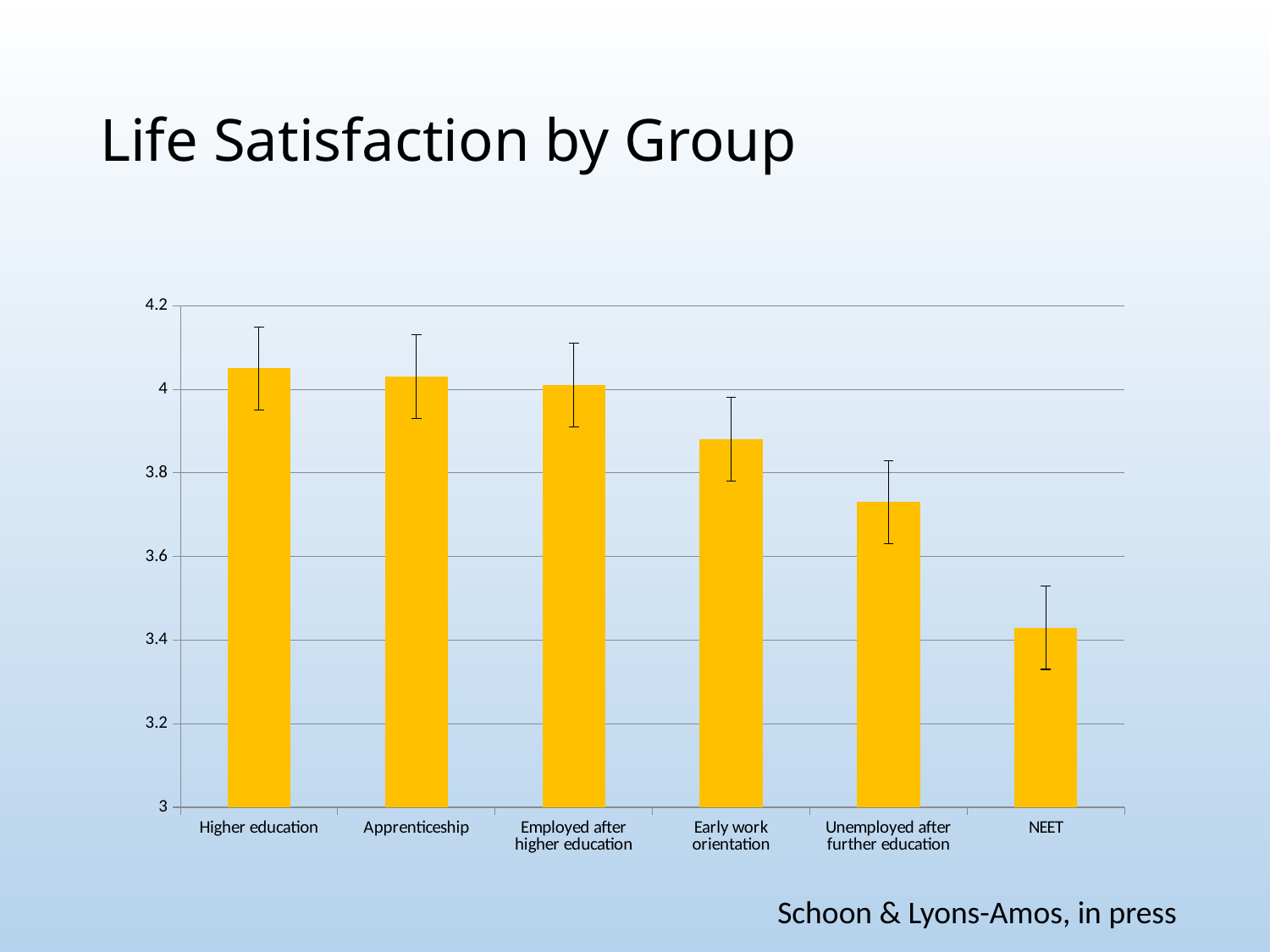
Which has the higher value: Early work orientation or NEET? Early work orientation Which has the higher value: Unemployed after further education or Higher education? Higher education Do the bar values rise or fall from left to right along the x axis? fall Which group has the lowest life satisfaction in the chart? NEET What is the title of the slide containing the chart? Life Satisfaction by Group What colour are the bars in the chart? Yellow Is the value for Early work orientation greater or less than 4? less What kind of chart is shown on the slide? Bar chart Is the value for Unemployed after further education greater or less than 3.8? less Is the value for Higher education greater or less than 4? greater How many groups are shown on the x axis of the chart? 6